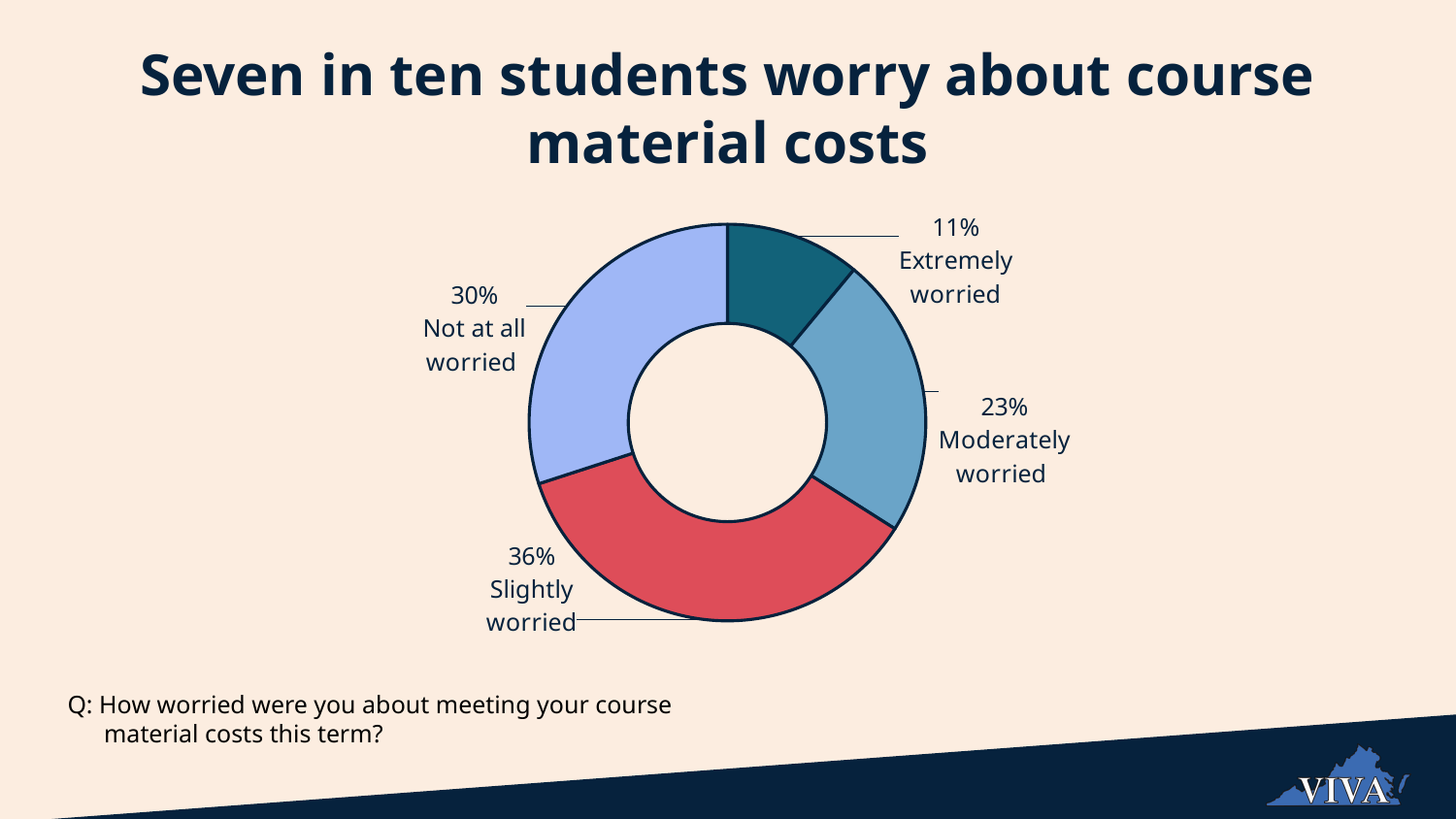
Which response category has the largest share of the pie? Slightly worried What is the title of the slide? Seven in ten students worry about course material costs Which response category has the smallest share of the pie? Extremely worried How many response categories are shown in the chart? 4 What kind of chart is shown on the slide? Doughnut chart What is the difference in percentage points between 'Moderately worried' and 'Extremely worried'? 12 What percentage of students were slightly worried about meeting their course material costs? 36% What percentage of students were extremely worried? 11% What percentage of students were moderately worried? 23% What percentage of students were not at all worried? 30% Which is larger: the share for 'Moderately worried' or the share for 'Not at all worried'? Not at all worried What is the difference in percentage points between 'Slightly worried' and 'Not at all worried'? 6